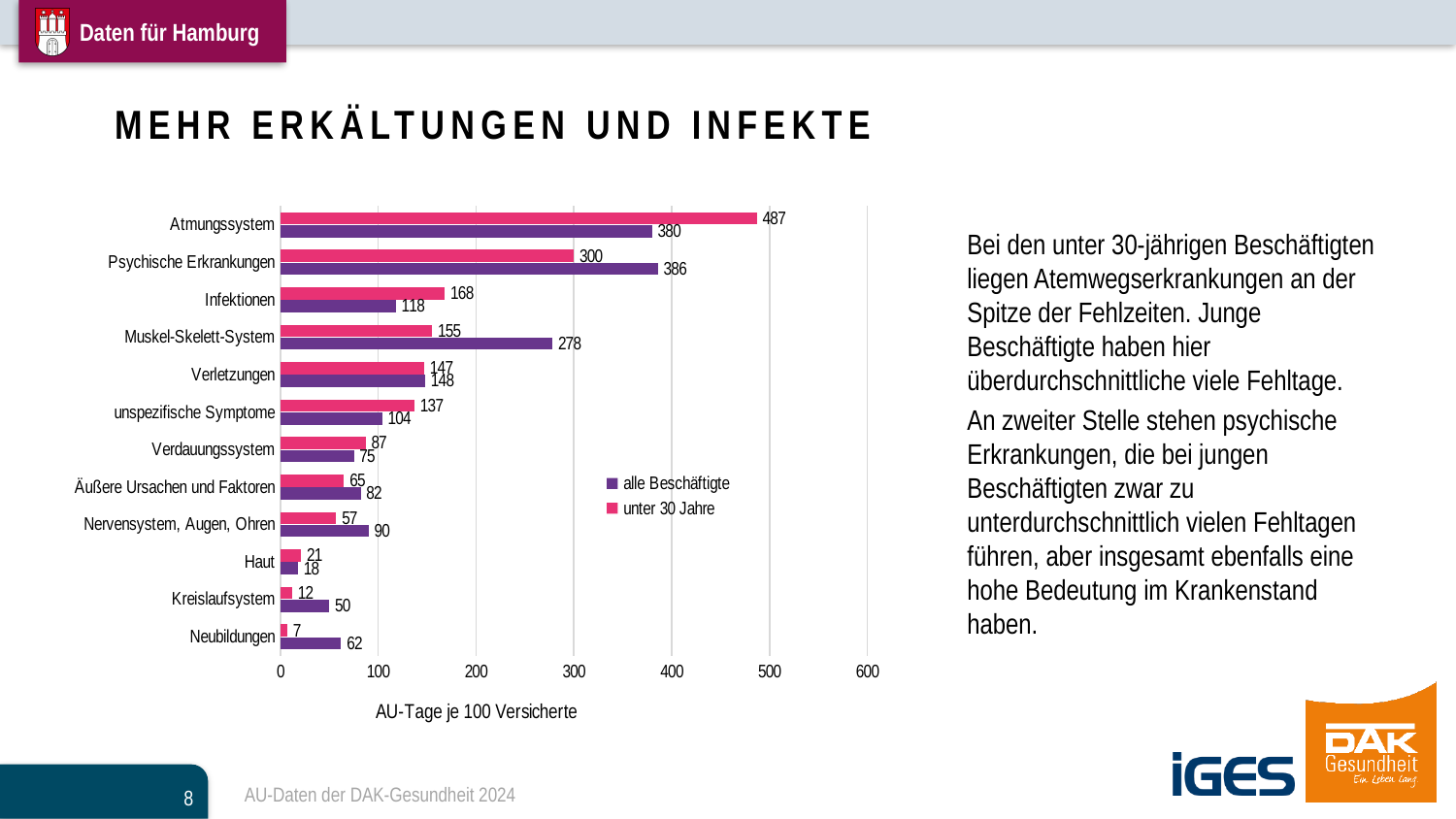
Is the value for "alle Beschäftigte" in the Kreislaufsystem category greater or less than 100? less How many series does the legend list? 2 What is the value for "unter 30 Jahre" in the Atmungssystem category? 487 Which category has the highest value for "unter 30 Jahre"? Atmungssystem How many categories are shown on the chart? 12 Which category has the lowest value for "unter 30 Jahre"? Neubildungen What is the value for "alle Beschäftigte" in the Muskel-Skelett-System category? 278 What is the label of the horizontal axis of the chart? AU-Tage je 100 Versicherte Which is larger for Infektionen: the value for "unter 30 Jahre" or for "alle Beschäftigte"? unter 30 Jahre What kind of chart is shown on the slide? Bar chart What is the value for "alle Beschäftigte" in the Psychische Erkrankungen category? 386 What is the difference between the "unter 30 Jahre" and "alle Beschäftigte" values for Atmungssystem? 107